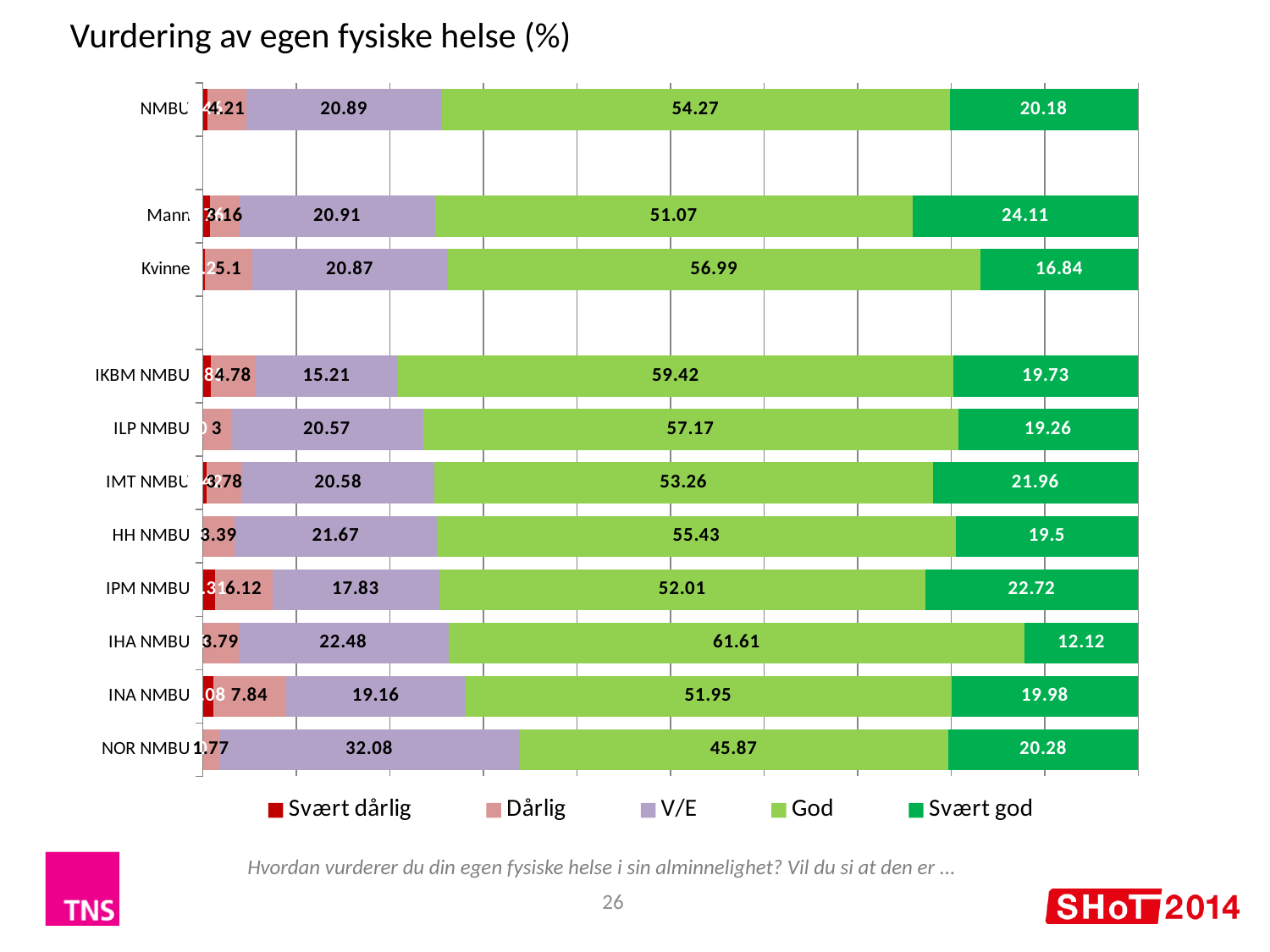
How many categories (bars) are plotted in the chart? 11 What is the title of the chart? Vurdering av egen fysiske helse (%) Which category has the lowest 'Svært god' value? IHA NMBU What is the 'Svært god' value for Mann? 24.11 What is the difference between the 'Svært god' values for Mann and Kvinne? 7.27 What is the 'God' value for IHA NMBU? 61.61 What kind of chart is shown on the slide? Stacked bar chart Which category has the highest 'God' value? IHA NMBU What is the 'V/E' value for NOR NMBU? 32.08 Which category has the lowest 'V/E' value? IKBM NMBU How many series does the legend list? 5 Which has the larger 'God' value, Kvinne or Mann? Kvinne